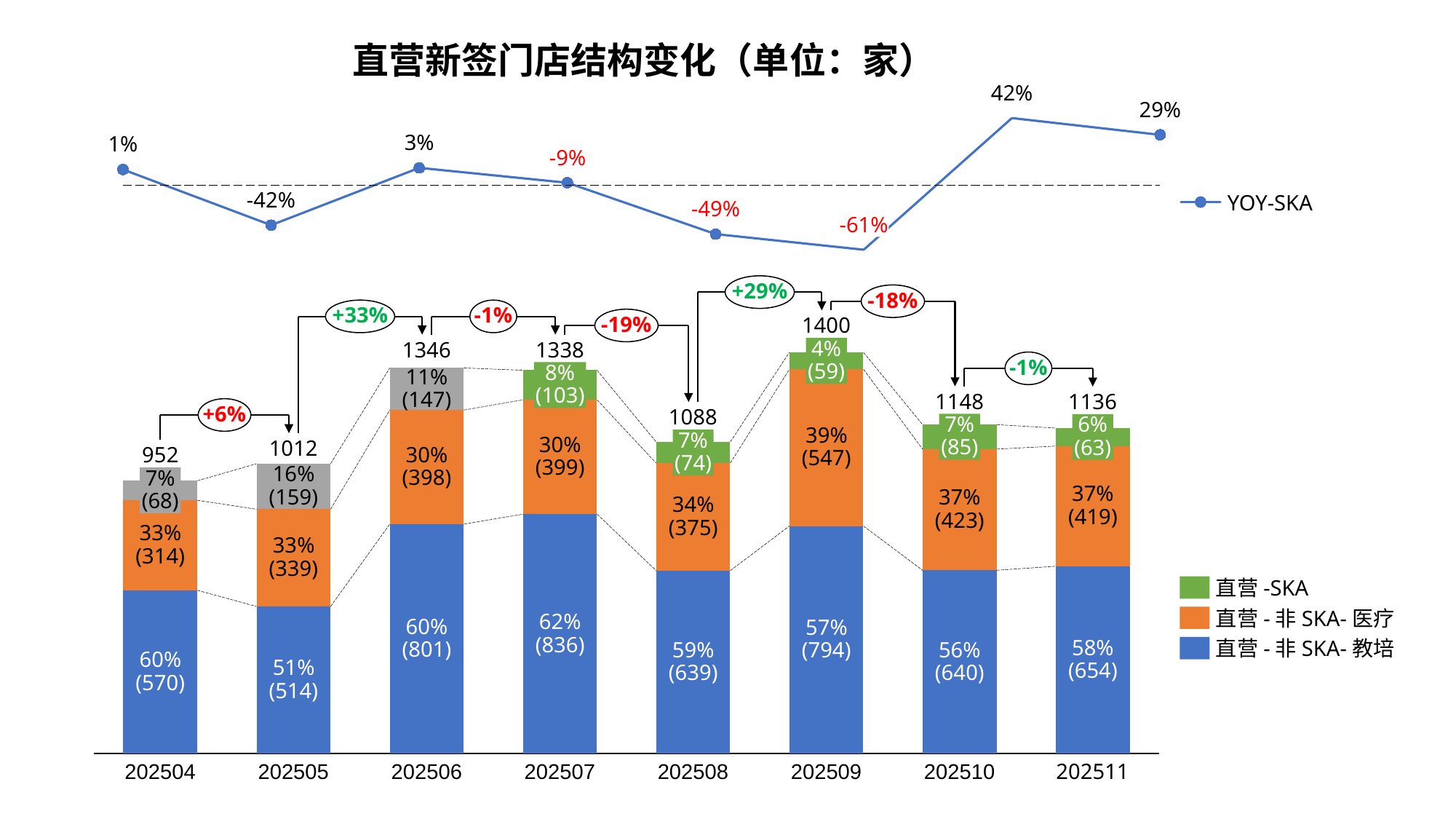
In the stacked bar chart, which month has the lowest total? 202504 In the stacked bar chart, what is the value of 直营-非SKA-医疗 for 202507? 399 In the stacked bar chart, what is the value of 直营-非SKA-教培 for 202509? 794 In the stacked bar chart, which is larger, the 直营-非SKA-医疗 value for 202510 or for 202511? 202510 What kind of chart is the lower chart on the slide? Stacked bar chart In the stacked bar chart, what is the total of the bar for 202506? 1346 In the stacked bar chart, what is the difference between the totals for 202509 and 202508? 312 How many months are shown on the x axis of the stacked bar chart? 8 In the YOY-SKA line chart, what is the value for 202510? 42% In the YOY-SKA line chart, which month has the lowest value? 202509 In the stacked bar chart, which month has the highest total? 202509 How many series does the legend of the stacked bar chart list? 3